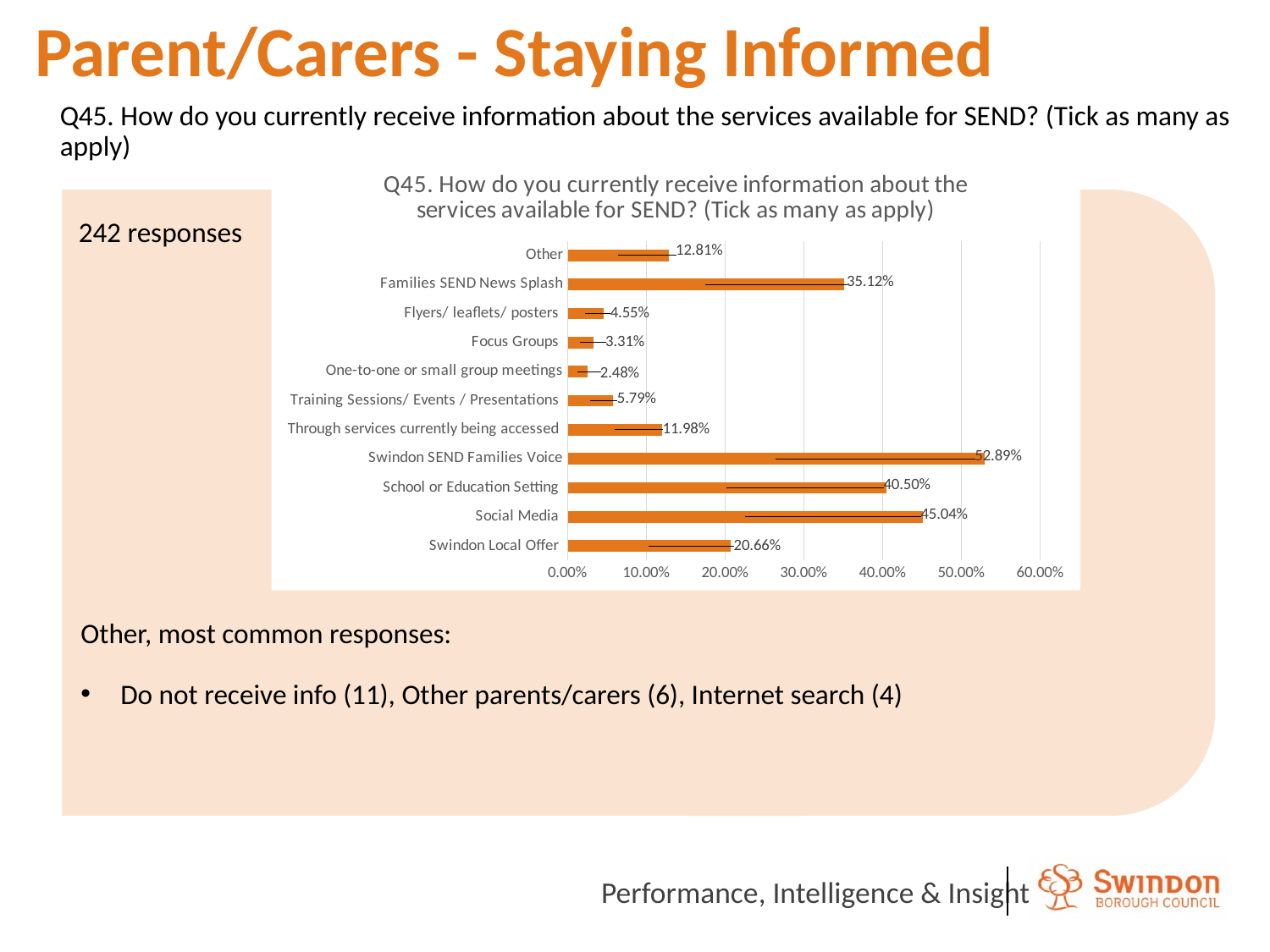
How many categories are shown in the chart? 11 What is the value shown for Swindon Local Offer? 20.66% What kind of chart is shown on the slide? Bar chart Which category has the lowest percentage in the chart? One-to-one or small group meetings What percentage is shown for Families SEND News Splash? 35.12% Which is larger, the value for Flyers/ leaflets/ posters or the value for Training Sessions/ Events / Presentations? Training Sessions/ Events / Presentations Which category has the highest percentage in the chart? Swindon SEND Families Voice Is the value for School or Education Setting greater or less than 40.00%? greater How many responses does the slide say the chart is based on? 242 responses What is the difference between the values for Social Media and School or Education Setting? 4.54% What percentage of respondents receive information through Social Media? 45.04% What is the difference between the values for Swindon SEND Families Voice and Swindon Local Offer? 32.23%